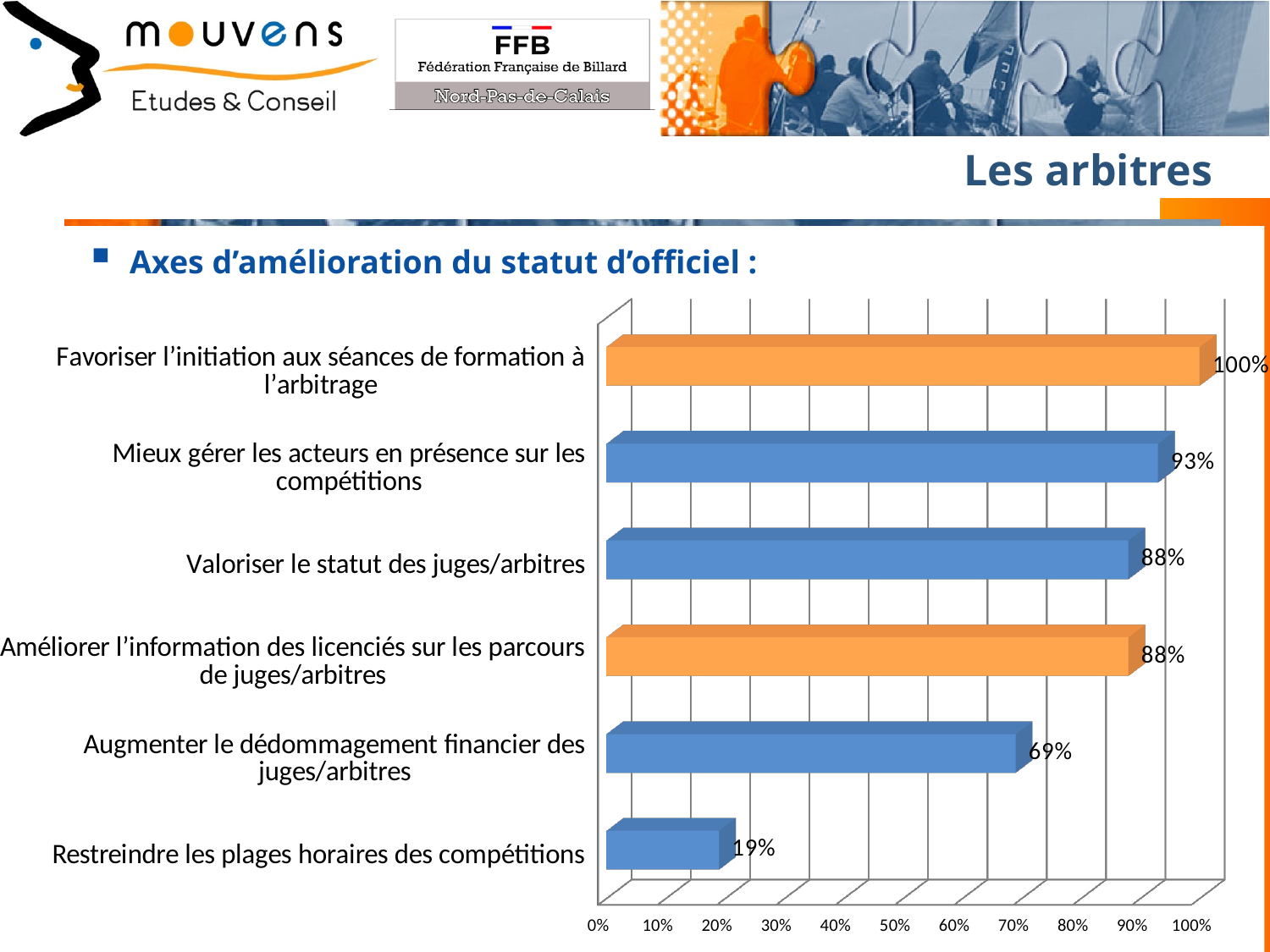
What is the value for "Mieux gérer les acteurs en présence sur les compétitions"? 93% What is the value for "Restreindre les plages horaires des compétitions"? 19% Which category has the lowest value? Restreindre les plages horaires des compétitions What is the difference between the values for "Mieux gérer les acteurs en présence sur les compétitions" and "Augmenter le dédommagement financier des juges/arbitres"? 24% Which is larger: the value for "Valoriser le statut des juges/arbitres" or the value for "Restreindre les plages horaires des compétitions"? Valoriser le statut des juges/arbitres What kind of chart is shown on the slide? bar chart What is the value for "Valoriser le statut des juges/arbitres"? 88% Which category has the highest value? Favoriser l'initiation aux séances de formation à l'arbitrage Is the value for "Augmenter le dédommagement financier des juges/arbitres" greater or less than 50%? greater How many categories are shown in the chart? 6 What is the value for "Favoriser l'initiation aux séances de formation à l'arbitrage"? 100% What is the value for "Augmenter le dédommagement financier des juges/arbitres"? 69%